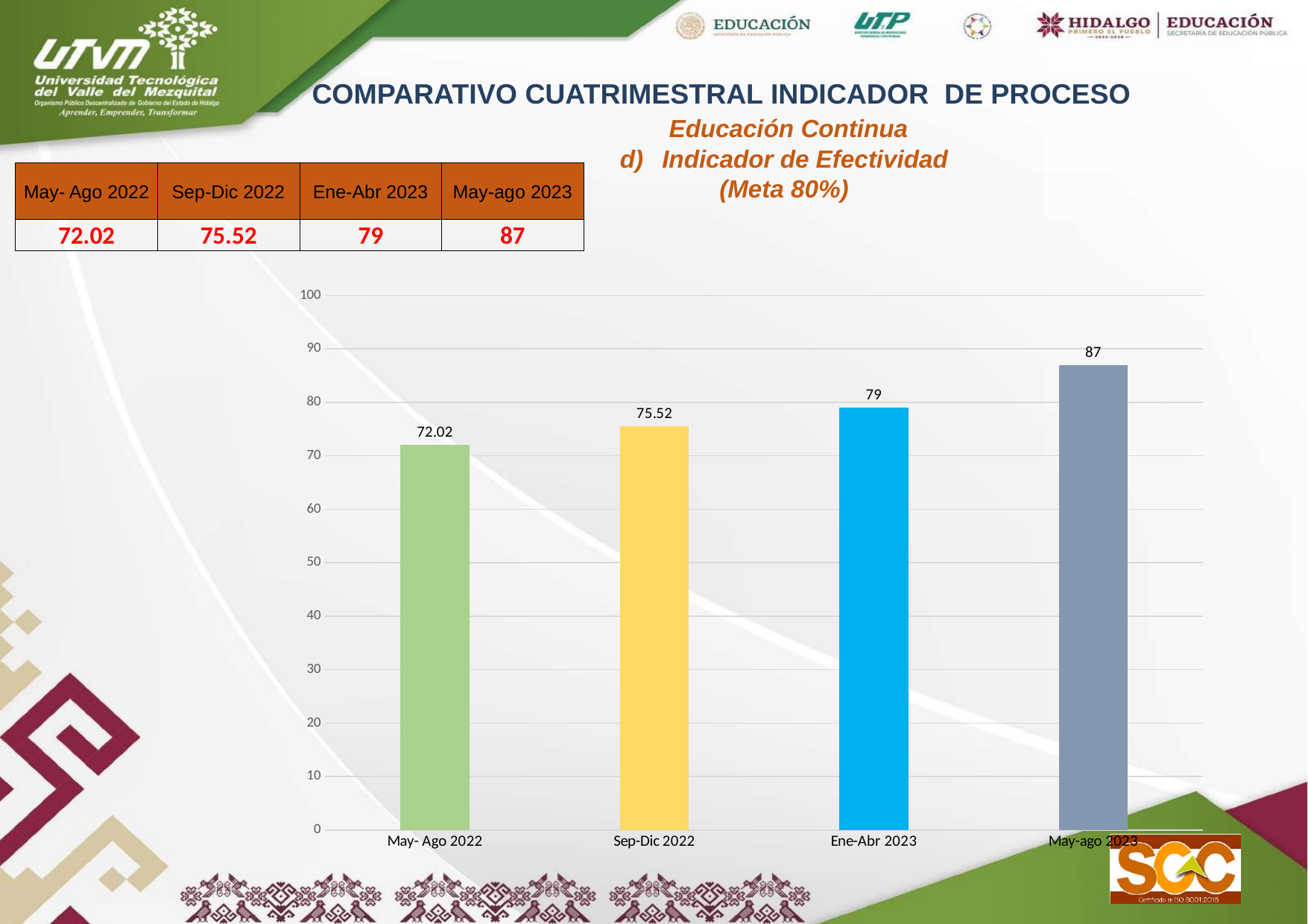
Do the values rise or fall from May- Ago 2022 to May-ago 2023? rise What is the value for May- Ago 2022? 72.02 What is the difference between the values for May-ago 2023 and Ene-Abr 2023? 8 Which is larger, the value for Ene-Abr 2023 or the value for Sep-Dic 2022? Ene-Abr 2023 What is the value for May-ago 2023? 87 What is the value for Sep-Dic 2022? 75.52 How many periods are shown on the chart? 4 Which period has the highest value? May-ago 2023 What kind of chart is shown? bar chart What is the difference between the values for Sep-Dic 2022 and May- Ago 2022? 3.5 What is the value for Ene-Abr 2023? 79 Which period has the lowest value? May- Ago 2022